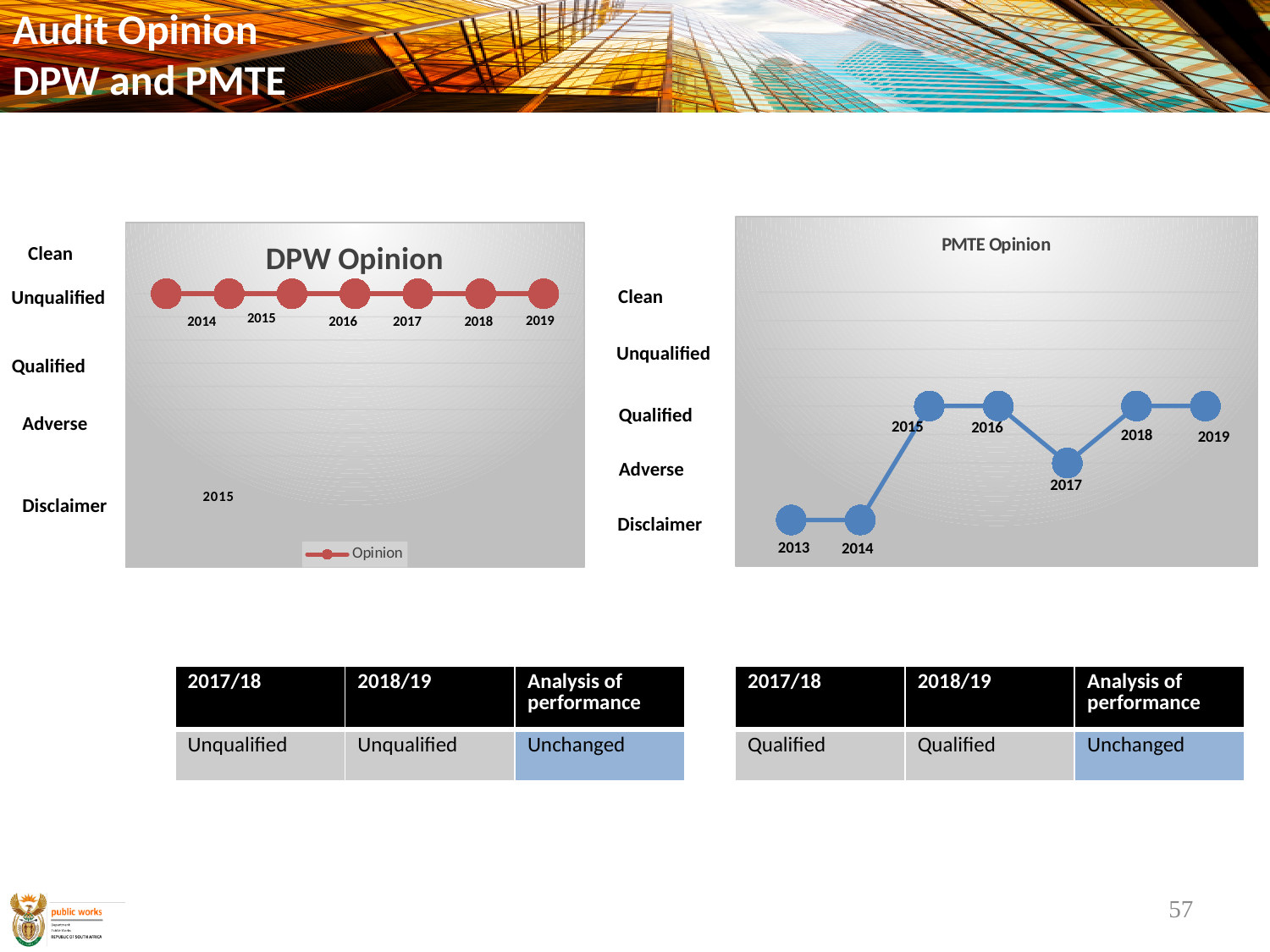
In the DPW Opinion chart, what audit opinion is shown for 2016? Unqualified In the PMTE Opinion chart, what audit opinion is shown for 2019? Qualified In the DPW Opinion chart, what audit opinion is shown for 2019? Unqualified How many series does the legend of the DPW Opinion chart list? 1 In the PMTE Opinion chart, does the opinion level rise or fall from 2014 to 2015? rise How many years are plotted in the PMTE Opinion chart? 7 In the PMTE Opinion chart, what audit opinion is shown for 2013? Disclaimer In the PMTE Opinion chart, what audit opinion is shown for 2017? Adverse What kind of chart is the DPW Opinion chart? line chart In the PMTE Opinion chart, which year has the lowest (worst) opinion level after 2014? 2017 What is the legend entry in the DPW Opinion chart? Opinion